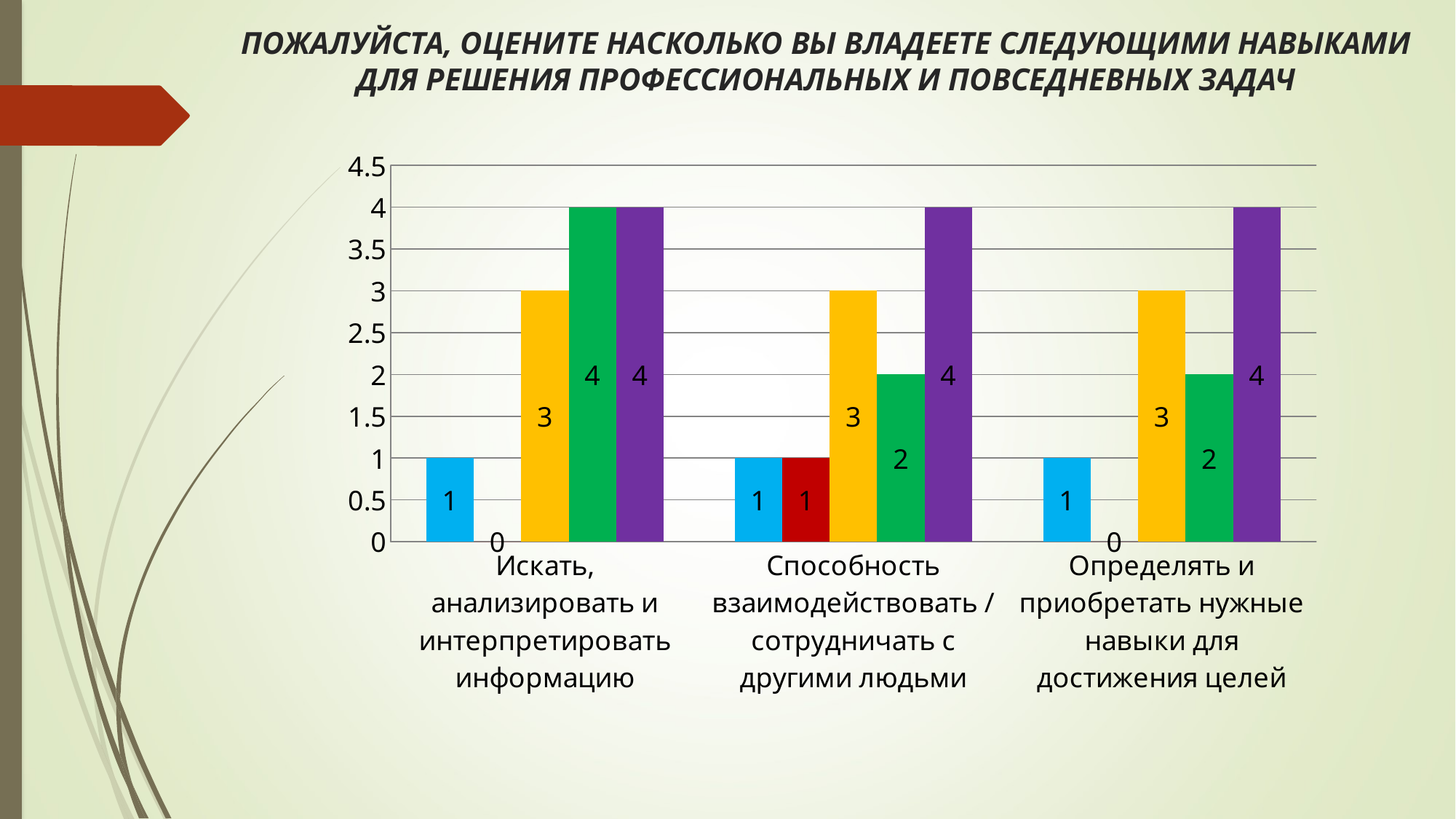
What is the value of the green bar for "Способность взаимодействовать / сотрудничать с другими людьми"? 2 What is the value of the red bar for "Способность взаимодействовать / сотрудничать с другими людьми"? 1 How many categories are shown on the x axis of the chart? 3 Which colour bar has the highest value for "Способность взаимодействовать / сотрудничать с другими людьми"? purple What kind of chart is shown on the slide? bar chart Which is larger for "Искать, анализировать и интерпретировать информацию": the blue bar or the yellow bar? the yellow bar What is the value of the red bar for "Определять и приобретать нужные навыки для достижения целей"? 0 What is the value of the yellow bar for "Определять и приобретать нужные навыки для достижения целей"? 3 How many differently coloured bar series appear in the chart? 5 What is the difference between the yellow bar and the blue bar for "Способность взаимодействовать / сотрудничать с другими людьми"? 2 What is the difference between the purple bar and the green bar for "Определять и приобретать нужные навыки для достижения целей"? 2 What is the value of the green bar for "Искать, анализировать и интерпретировать информацию"? 4